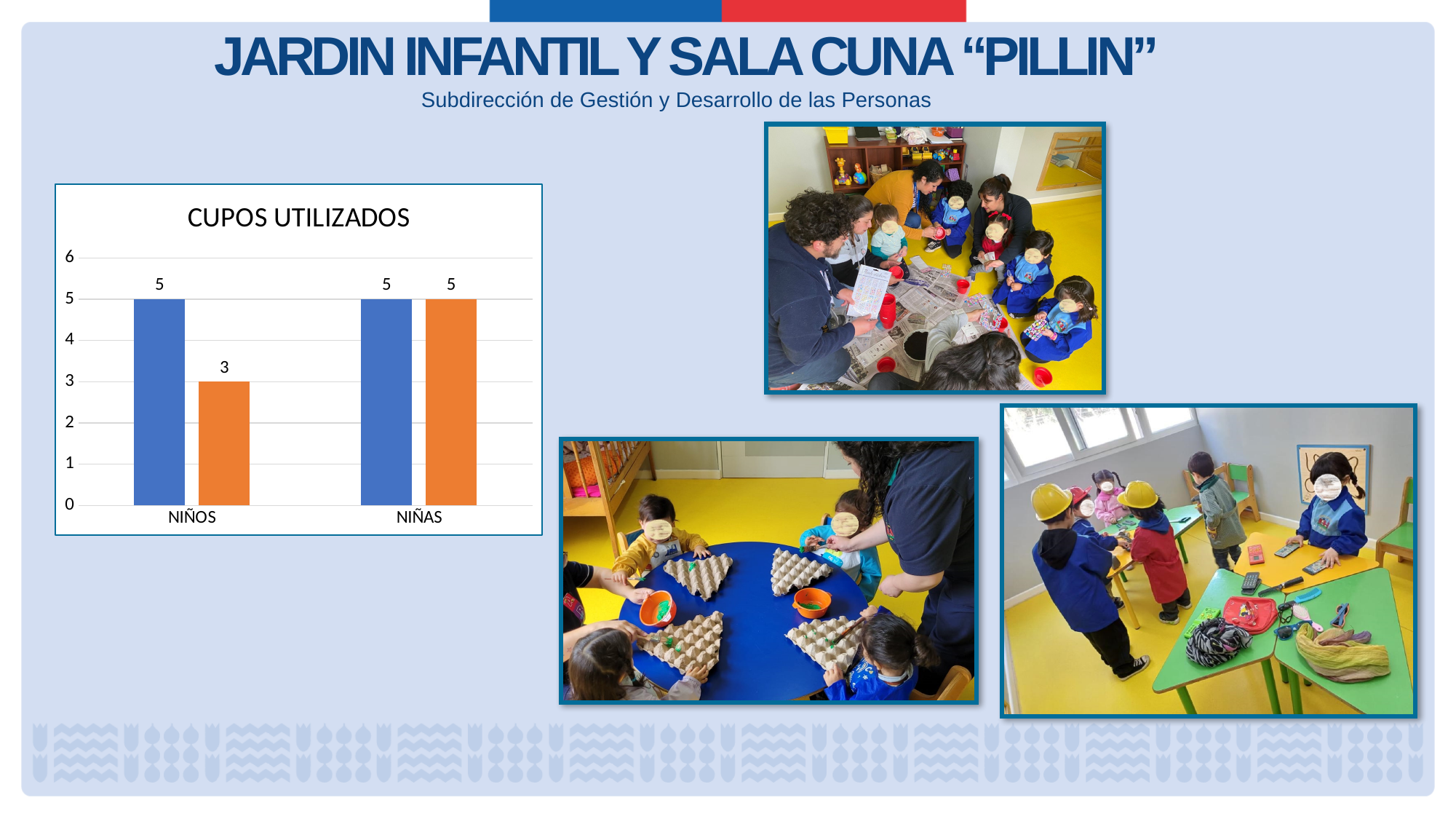
What is the value of the orange bar for NIÑAS? 5 What is the highest value shown on the y axis of the chart? 6 What is the value of the blue bar for NIÑOS? 5 What is the difference between the orange bar for NIÑAS and the orange bar for NIÑOS? 2 What is the title of the chart? CUPOS UTILIZADOS Is the value of the orange bar for NIÑOS greater or less than 4? less What kind of chart is shown on the slide? bar chart Which category has the larger orange bar, NIÑOS or NIÑAS? NIÑAS What is the value of the orange bar for NIÑOS? 3 What is the difference between the blue bar and the orange bar for NIÑOS? 2 How many categories are shown on the x axis of the chart? 2 Which bar in the chart has the lowest value? the orange bar for NIÑOS